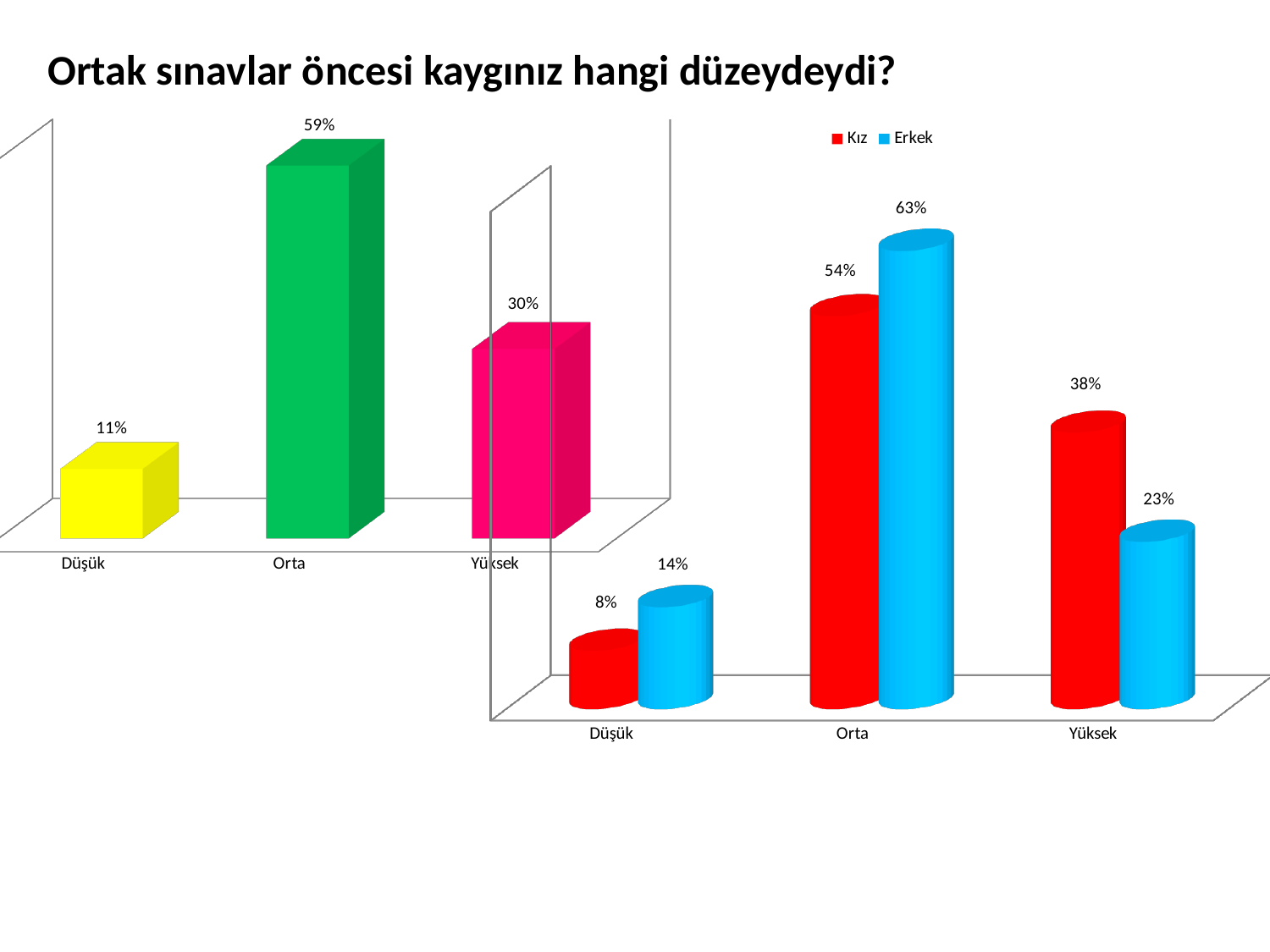
In the left chart, which category has the lowest value? Düşük In the left chart, what is the difference between the values for Orta and Yüksek? 29% In the right chart, what is the Erkek value for Orta? 63% In the right chart, which category has the highest Kız value? Orta In the right chart, what is the Kız value for Yüksek? 38% What kind of chart is the right chart? Bar chart In the right chart, which colour represents the Erkek series? Blue In the left chart, how many categories are shown? 3 In the right chart, which series has the higher value for Yüksek, Kız or Erkek? Kız In the right chart, what is the difference between the Erkek and Kız values for Düşük? 6% How many series does the legend of the right chart list? 2 In the left chart, what is the value for Orta? 59%